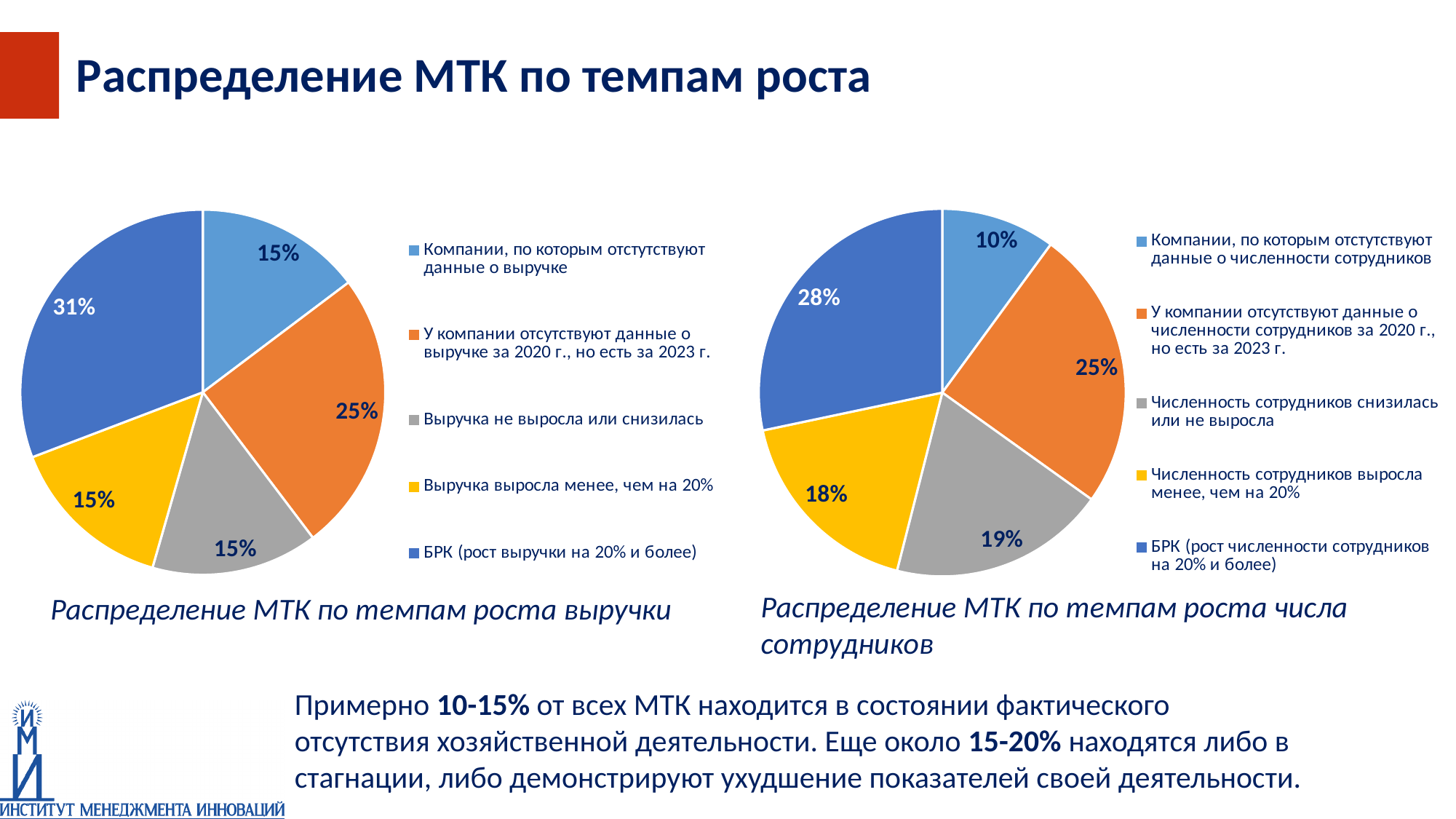
In the left pie chart (Распределение МТК по темпам роста выручки), what share is shown for 'У компании отсутствуют данные о выручке за 2020 г., но есть за 2023 г.'? 25% In the left pie chart (Распределение МТК по темпам роста выручки), how many slices does the pie have? 5 What type of chart is used on this slide? Pie chart In the left pie chart (Распределение МТК по темпам роста выручки), what share is labelled for БРК (рост выручки на 20% и более)? 31% In the right pie chart (Распределение МТК по темпам роста числа сотрудников), what share is shown for 'Компании, по которым отсутствуют данные о численности сотрудников'? 10% In the left pie chart (Распределение МТК по темпам роста выручки), what colour is the slice for 'Выручка выросла менее, чем на 20%'? Yellow In the left pie chart (Распределение МТК по темпам роста выручки), which category has the largest slice? БРК (рост выручки на 20% и более) In the right pie chart (Распределение МТК по темпам роста числа сотрудников), which is larger: the БРК slice or the 'У компании отсутствуют данные о численности сотрудников за 2020 г., но есть за 2023 г.' slice? БРК (рост численности сотрудников на 20% и более) In the right pie chart (Распределение МТК по темпам роста числа сотрудников), which category has the smallest slice? Компании, по которым отсутствуют данные о численности сотрудников In the left pie chart (Распределение МТК по темпам роста выручки), what is the difference between the БРК slice and the 'Выручка выросла менее, чем на 20%' slice? 16 percentage points In the right pie chart (Распределение МТК по темпам роста числа сотрудников), what is the difference between the БРК slice and the 'Численность сотрудников выросла менее, чем на 20%' slice? 10 percentage points In the right pie chart (Распределение МТК по темпам роста числа сотрудников), what share is shown for 'Численность сотрудников снизилась или не выросла'? 19%